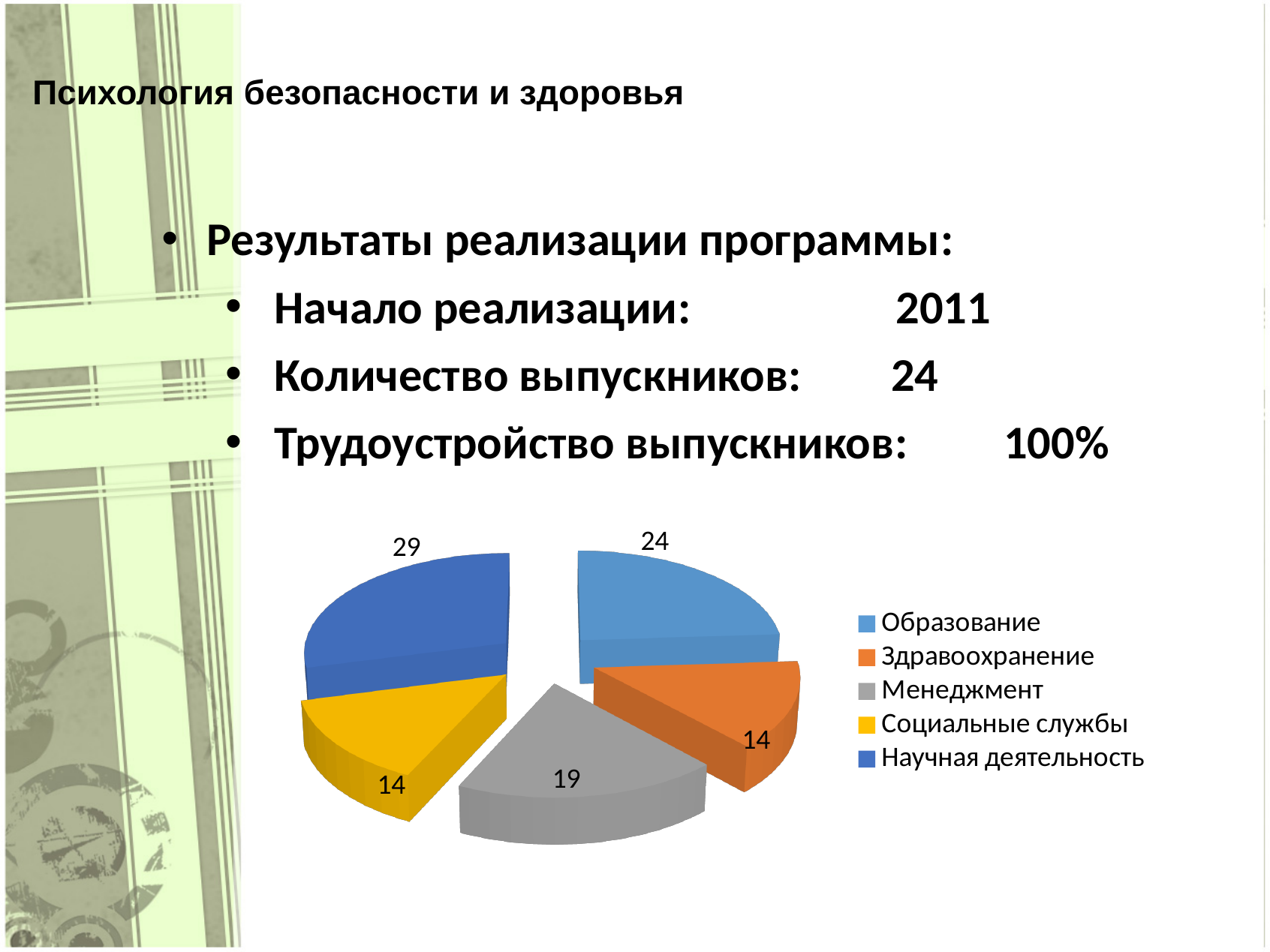
What share of the pie does Научная деятельность represent? 29% What is the value for Здравоохранение in the pie chart? 14 What is the difference between the values for Научная деятельность and Образование? 5 Which is larger, the value for Образование or the value for Менеджмент? Образование What is the difference between the values for Менеджмент and Социальные службы? 5 What is the value for Образование in the pie chart? 24 Which category has the largest slice in the pie chart? Научная деятельность What is the value for Научная деятельность in the pie chart? 29 What type of chart is shown on the slide? pie chart How many slices does the pie chart have? 5 What is the value for Менеджмент in the pie chart? 19 What colour is the slice for Социальные службы? yellow